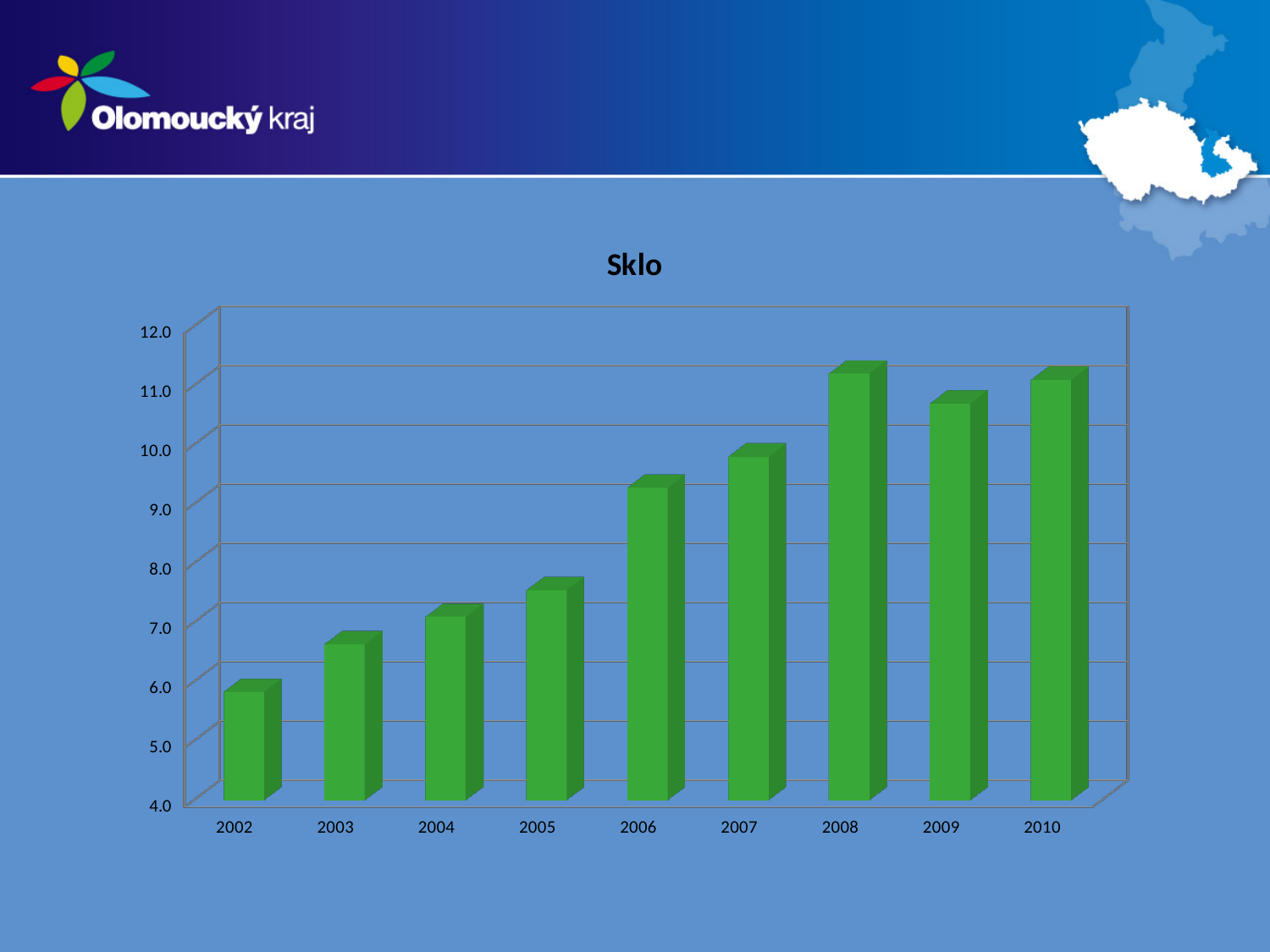
What is the title of the chart? Sklo Is the value for 2009 greater or less than 10.0? greater Which year has the lowest value in the chart? 2002 Is the value for 2008 greater or less than 11.0? greater How many years are shown on the x axis of the chart? 9 Is the value for 2007 greater or less than 10.0? less Do the values generally rise or fall from 2002 to 2010? rise Which is larger, the value for 2005 or the value for 2006? 2006 What kind of chart is shown on the slide? bar chart Which is larger, the value for 2008 or the value for 2009? 2008